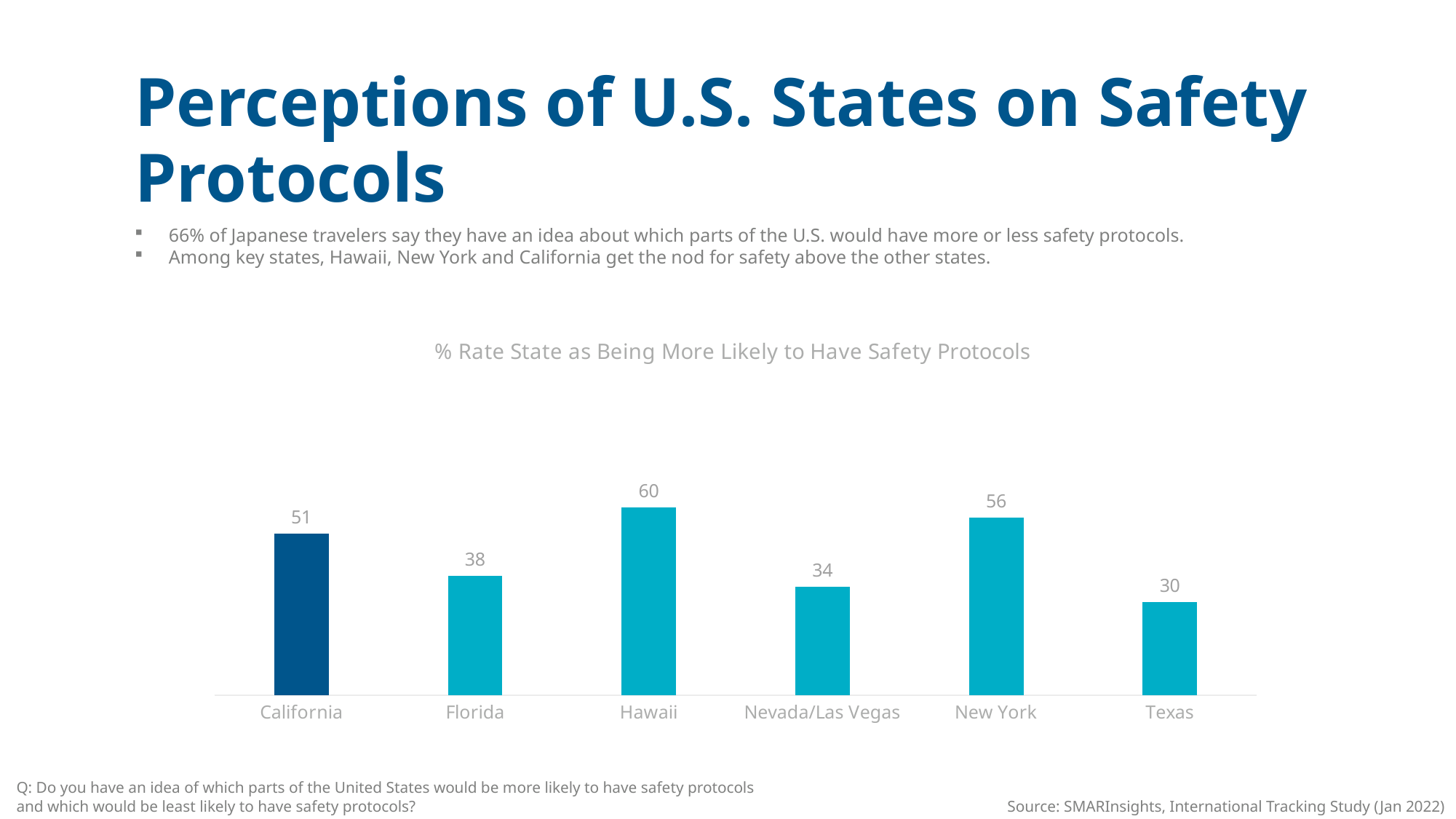
What is the value for Hawaii? 60 What is the difference between the values for Hawaii and Texas? 30 Which has a larger value, California or New York? New York What is the title of the chart? % Rate State as Being More Likely to Have Safety Protocols What is the value for Nevada/Las Vegas? 34 What is the value for California? 51 Which state has the lowest value? Texas Which state has the highest value? Hawaii What kind of chart is shown on the slide? Bar chart How many states are shown in the chart? 6 Which has a larger value, Florida or Nevada/Las Vegas? Florida What is the difference between the values for New York and Florida? 18